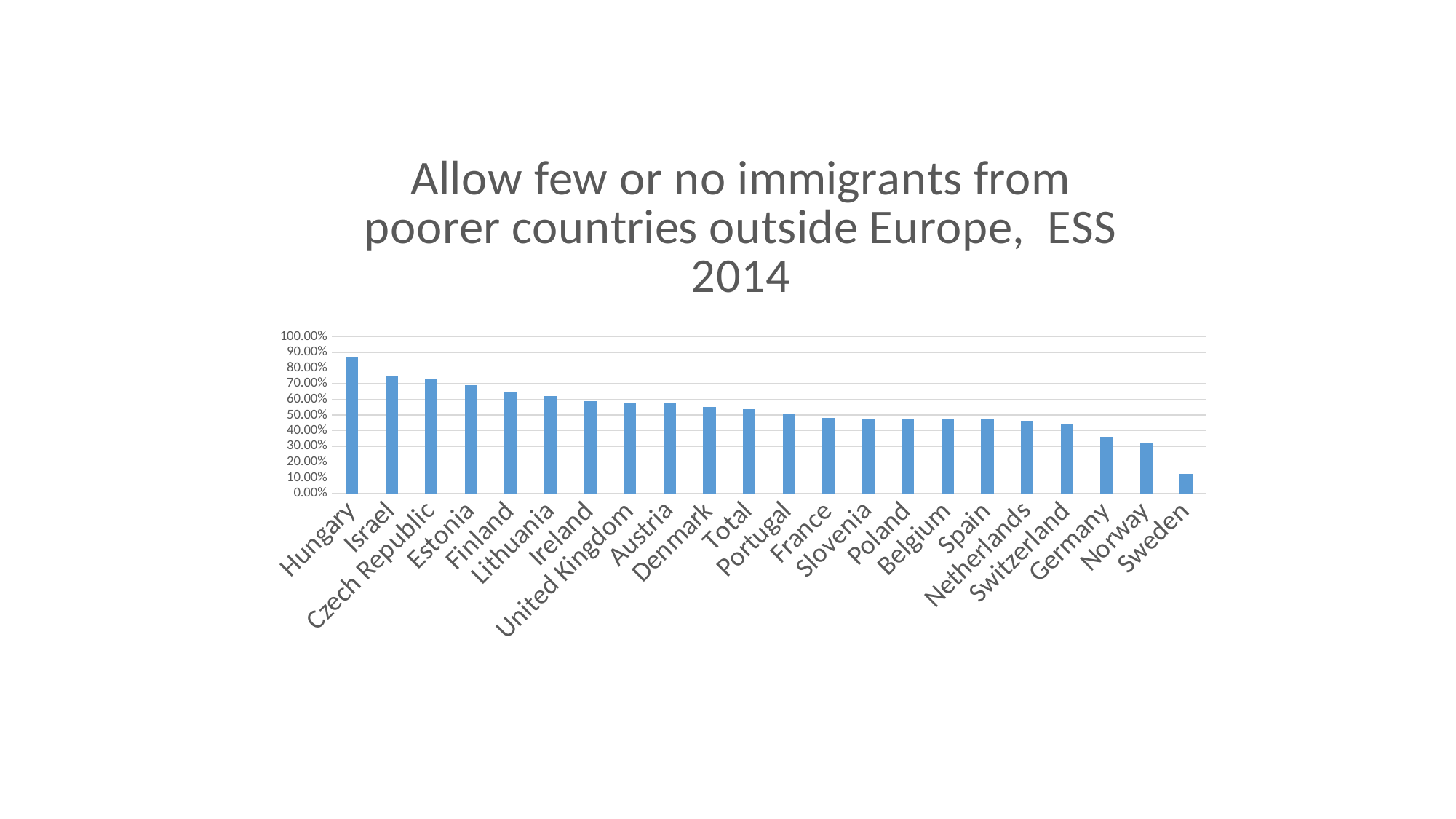
Is the value for Sweden greater or less than 20.00%? less Is the value for Switzerland greater or less than 50.00%? less Which country has the highest value in the chart? Hungary Is the value for Germany greater or less than 40.00%? less Which country has the lowest value in the chart? Sweden Do the values generally rise or fall moving from left to right along the x axis? fall Which is larger, the value for Israel or the value for Norway? Israel What is the title of the chart? Allow few or no immigrants from poorer countries outside Europe, ESS 2014 How many categories are plotted along the x axis? 22 What kind of chart is shown on the slide? bar chart